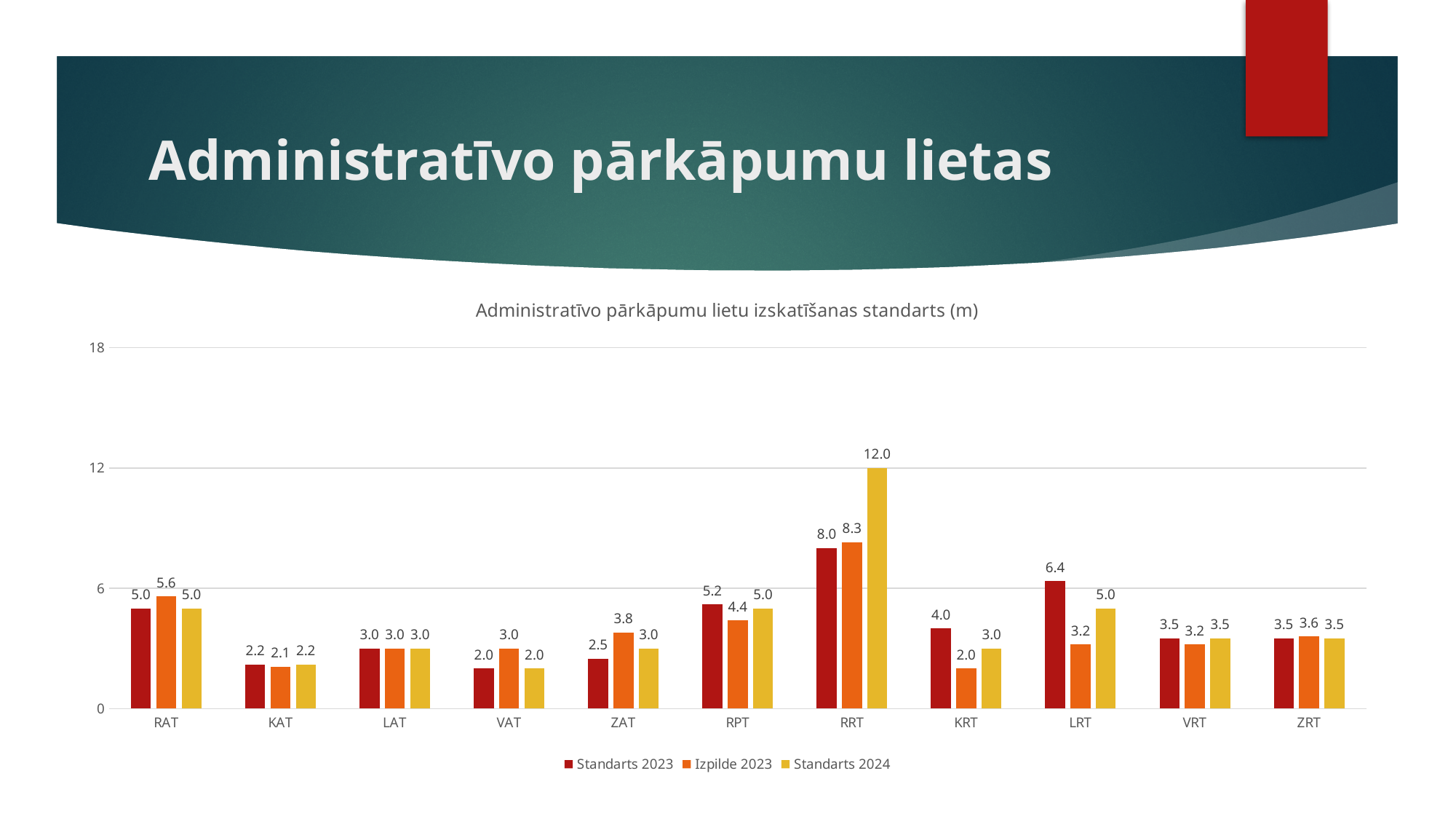
How many categories are shown on the x axis? 11 What is the difference between the Standarts 2024 and Standarts 2023 values for RRT? 4.0 What is the Standarts 2024 value for LRT? 5.0 Which category has the highest Standarts 2024 value? RRT Which is larger for LRT: Standarts 2023 or Izpilde 2023? Standarts 2023 Which category has the lowest Standarts 2023 value? VAT What kind of chart is shown on the slide? bar chart How many series does the legend list? 3 What is the Izpilde 2023 value for RRT? 8.3 Is the Standarts 2024 value for RRT greater or less than 6? greater What is the Standarts 2023 value for ZAT? 2.5 What is the title of the chart? Administratīvo pārkāpumu lietu izskatīšanas standarts (m)